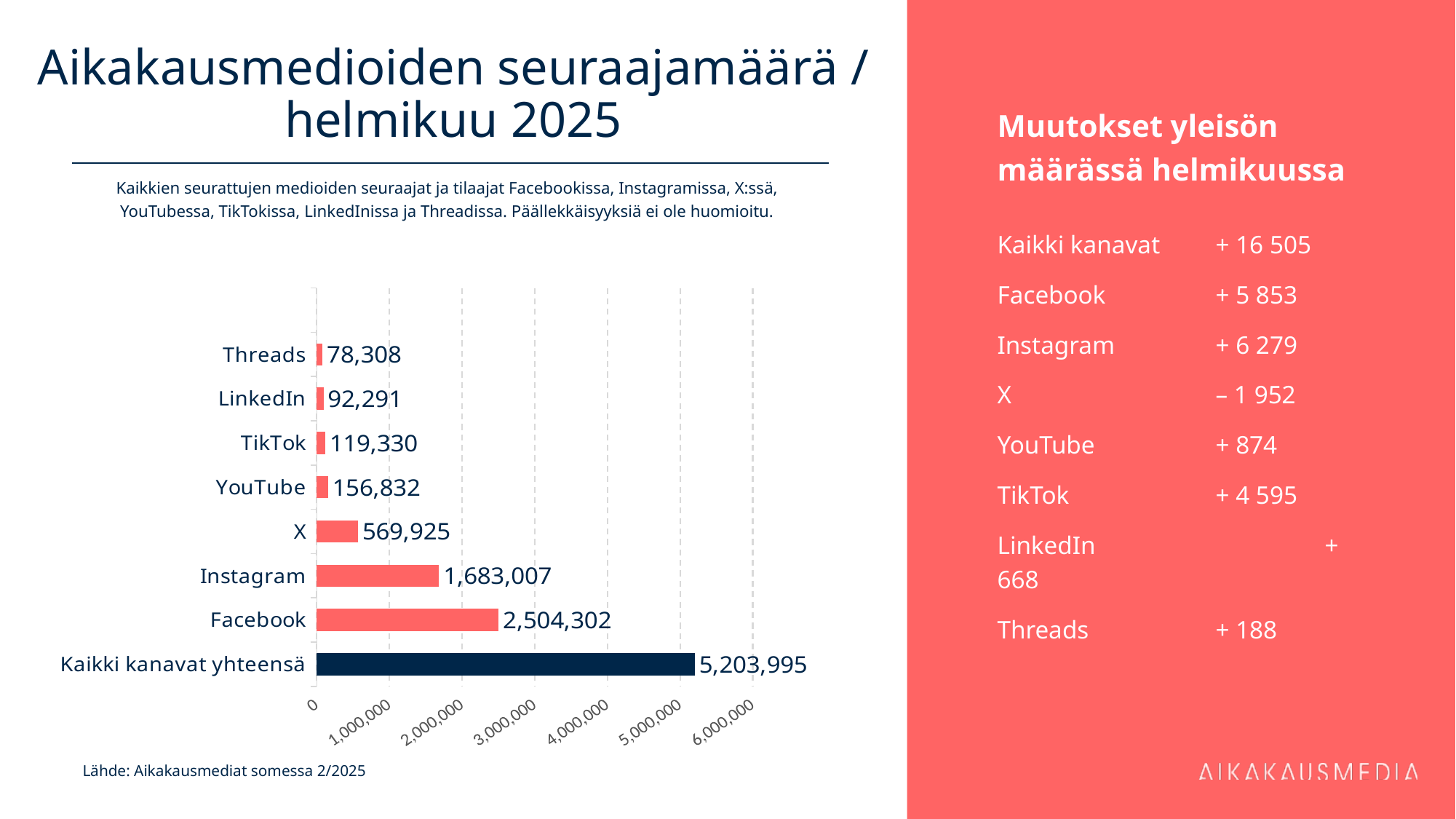
What is the difference between the values for Facebook and Instagram? 821,295 What is the title of the slide containing the chart? Aikakausmedioiden seuraajamäärä / helmikuu 2025 Which category has the lowest value in the bar chart? Threads What is the difference between the values for X and YouTube? 413,093 How many categories are shown in the bar chart? 8 What is the value for Kaikki kanavat yhteensä in the bar chart? 5,203,995 What is the value for Instagram in the bar chart? 1,683,007 What kind of chart is shown on the slide? Bar chart What is the value for Threads in the bar chart? 78,308 Which category has the highest value in the bar chart? Kaikki kanavat yhteensä Which is larger, the value for TikTok or the value for LinkedIn? TikTok What is the value for Facebook in the bar chart? 2,504,302